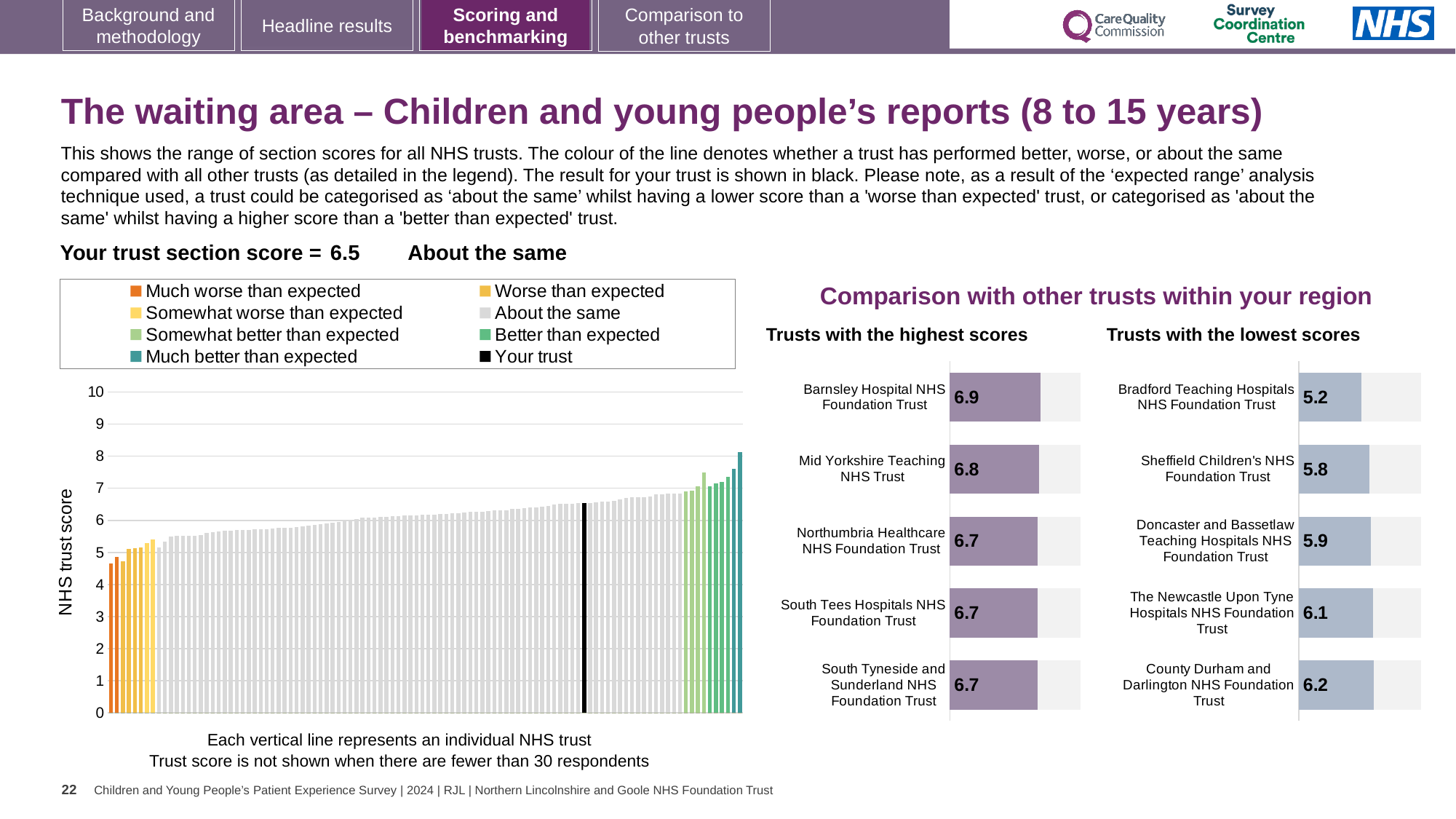
In the 'Trusts with the lowest scores' chart, what is the score for Sheffield Children's NHS Foundation Trust? 5.8 What kind of chart is the main 'NHS trust score' chart on the left? bar chart In the 'Trusts with the highest scores' chart, what is the difference between the scores of Barnsley Hospital NHS Foundation Trust and Mid Yorkshire Teaching NHS Trust? 0.1 How many trusts are shown in the 'Trusts with the highest scores' chart? 5 In the 'Trusts with the lowest scores' chart, which has the higher score: Doncaster and Bassetlaw Teaching Hospitals NHS Foundation Trust or Sheffield Children's NHS Foundation Trust? Doncaster and Bassetlaw Teaching Hospitals NHS Foundation Trust In the 'Trusts with the highest scores' chart, which trust has the highest score? Barnsley Hospital NHS Foundation Trust How many entries does the legend of the main 'NHS trust score' chart list? 8 In the main 'NHS trust score' chart on the left, is the value of the lowest bar greater or less than 5? less In the 'Trusts with the lowest scores' chart, which trust has the lowest score? Bradford Teaching Hospitals NHS Foundation Trust In the main 'NHS trust score' chart on the left, what is the score of the black bar representing your trust? 6.5 In the 'Trusts with the highest scores' chart, what is the score for Barnsley Hospital NHS Foundation Trust? 6.9 In the 'Trusts with the lowest scores' chart, what is the difference between the scores of County Durham and Darlington NHS Foundation Trust and Bradford Teaching Hospitals NHS Foundation Trust? 1.0